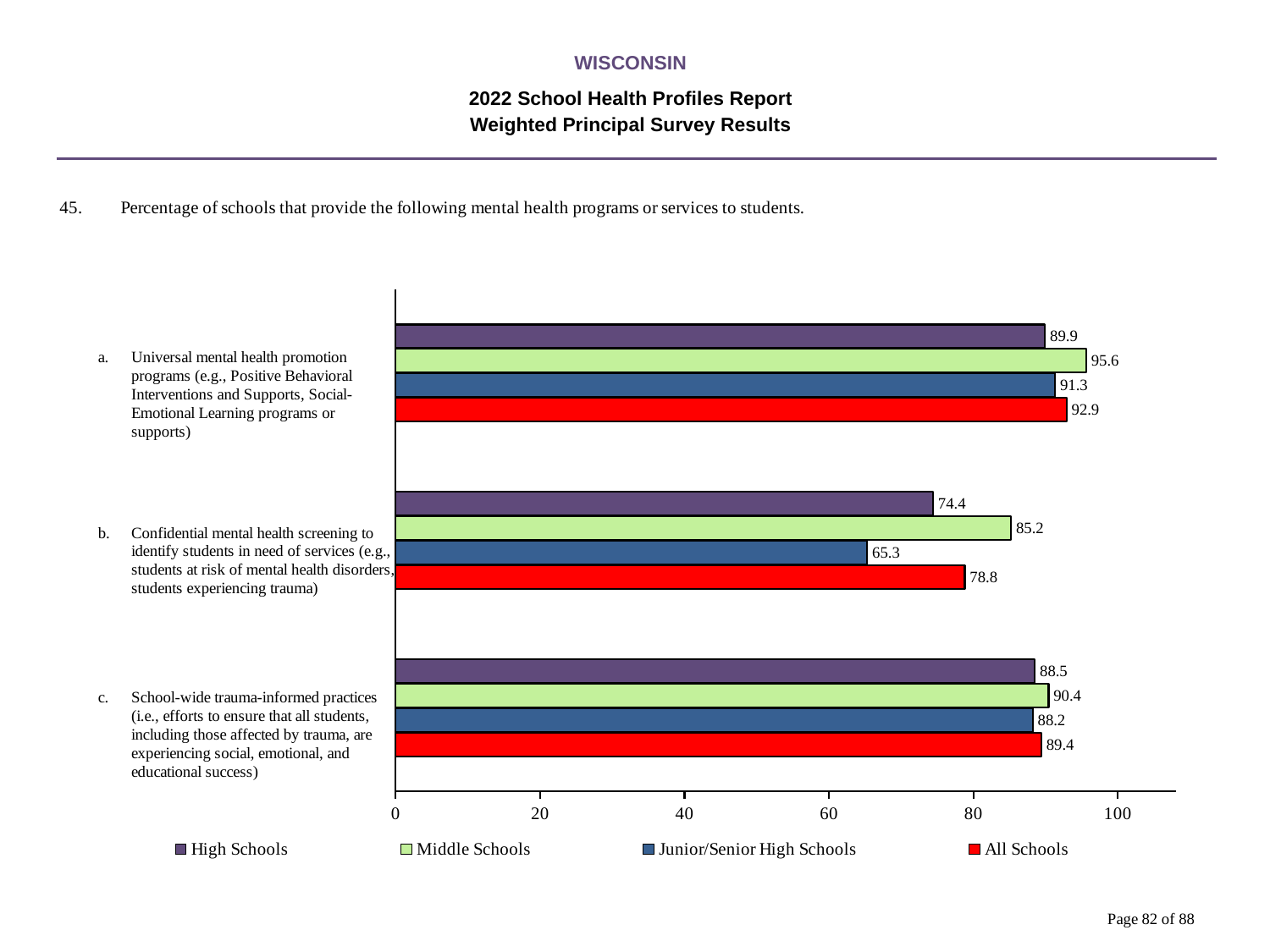
For school-wide trauma-informed practices (item c), which is larger: the High Schools value or the Middle Schools value? Middle Schools What is the difference between the Middle Schools and High Schools values for confidential mental health screening (item b)? 10.8 Is the High Schools value for confidential mental health screening (item b) greater or less than 80? less What is the value for Middle Schools for universal mental health promotion programs (item a)? 95.6 Which school type has the lowest value for confidential mental health screening (item b)? Junior/Senior High Schools Which colour represents All Schools in the legend? red How many series does the legend list? 4 Which school type has the highest value for universal mental health promotion programs (item a)? Middle Schools What kind of chart is shown on the slide? bar chart What is the value for All Schools for school-wide trauma-informed practices (item c)? 89.4 How many mental health programs or services (categories) are shown on the chart? 3 What is the value for Junior/Senior High Schools for confidential mental health screening (item b)? 65.3